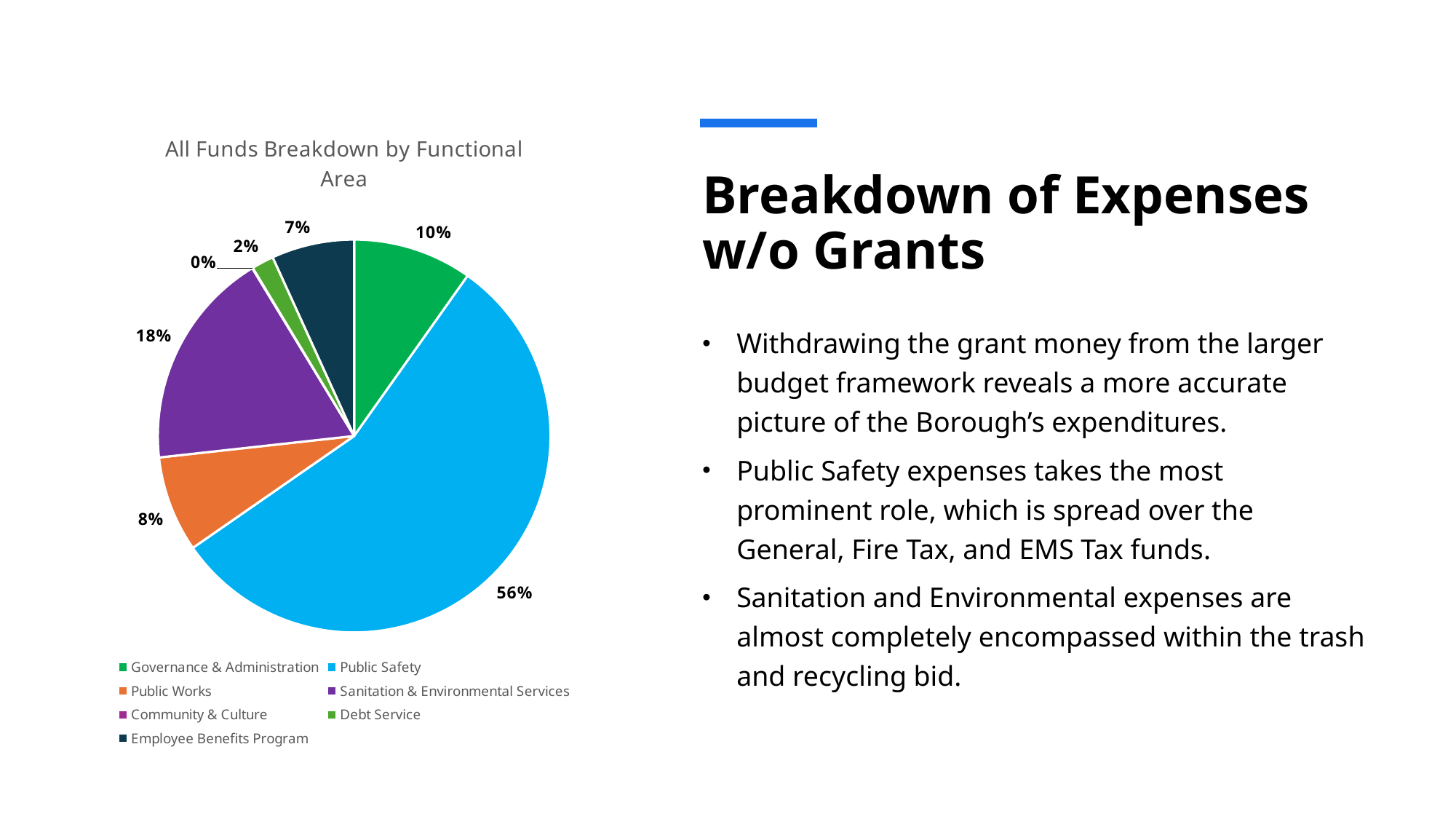
Which functional area has the smallest share of the pie? Community & Culture How many categories does the legend list? 7 What is the value for Employee Benefits Program? 7% What is the difference between the Public Safety share and the Sanitation & Environmental Services share? 38% What kind of chart is shown on the slide? pie chart What is the value for Debt Service? 2% Which functional area has the largest share of the pie? Public Safety Which is larger, the share for Public Works or the share for Governance & Administration? Governance & Administration What share of the pie does Public Safety take? 56% What share of the pie does Sanitation & Environmental Services take? 18% What is the title of the chart? All Funds Breakdown by Functional Area What is the value for Governance & Administration? 10%